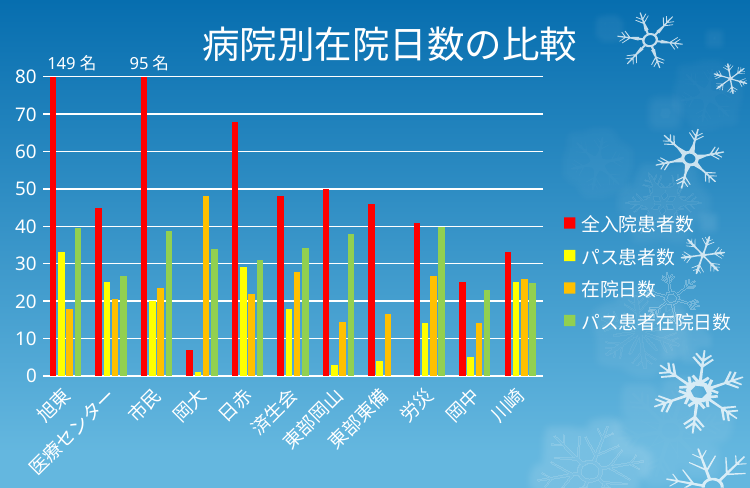
Is the 全入院患者数 value for 日赤 greater or less than 60? greater What is the 全入院患者数 value for 市民? 95 名 How many hospitals are shown on the x axis of the chart? 11 What is the difference between the 全入院患者数 values for 旭東 and 市民? 54 名 How many series does the legend list? 4 What kind of chart is shown on the slide? bar chart Which has the larger 全入院患者数, 日赤 or 済生会? 日赤 Which hospital has the lowest 全入院患者数? 岡大 What colour represents 全入院患者数 in the legend? red What is the 全入院患者数 value for 旭東? 149 名 Which hospital has the highest 全入院患者数? 旭東 Is the 全入院患者数 value for 岡大 greater or less than 10? less